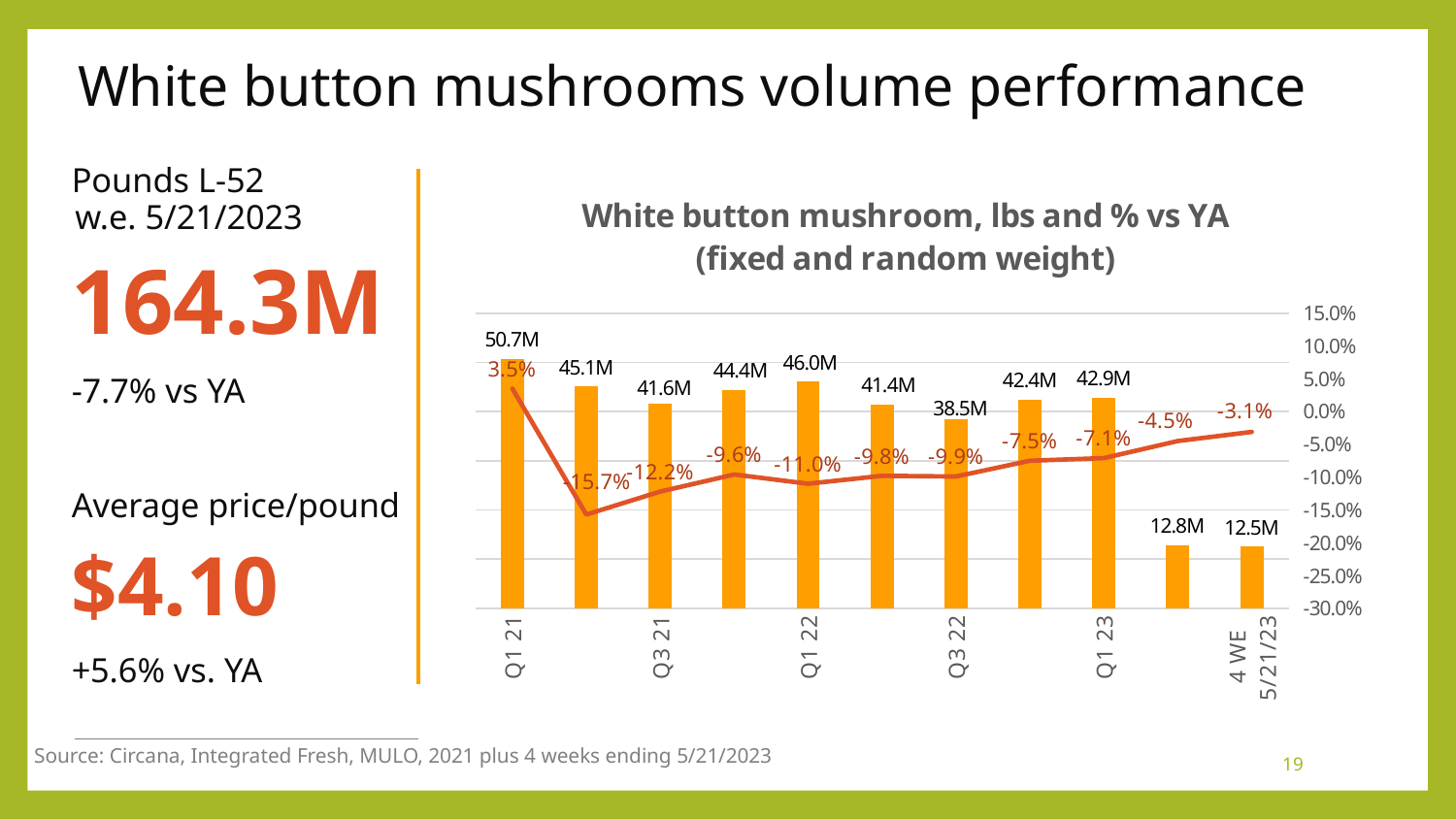
What is the volume in pounds for Q1 21? 50.7M Which has the higher volume in pounds, Q1 22 or Q3 22? Q1 22 What kind of chart is shown on the slide? Combination bar and line chart What is the % vs YA value for the 4 WE 5/21/23 period? -3.1% What is the % vs YA value for Q3 22? -9.9% How many bars are plotted in the chart? 11 What is the difference in volume between Q1 21 and Q3 21? 9.1M Which labeled period has the highest volume in pounds? Q1 21 Which labeled period has the lowest volume in pounds? 4 WE 5/21/23 What is the volume in pounds for Q1 22? 46.0M What is the title of the chart? White button mushroom, lbs and % vs YA (fixed and random weight) What is the volume in pounds for Q1 23? 42.9M